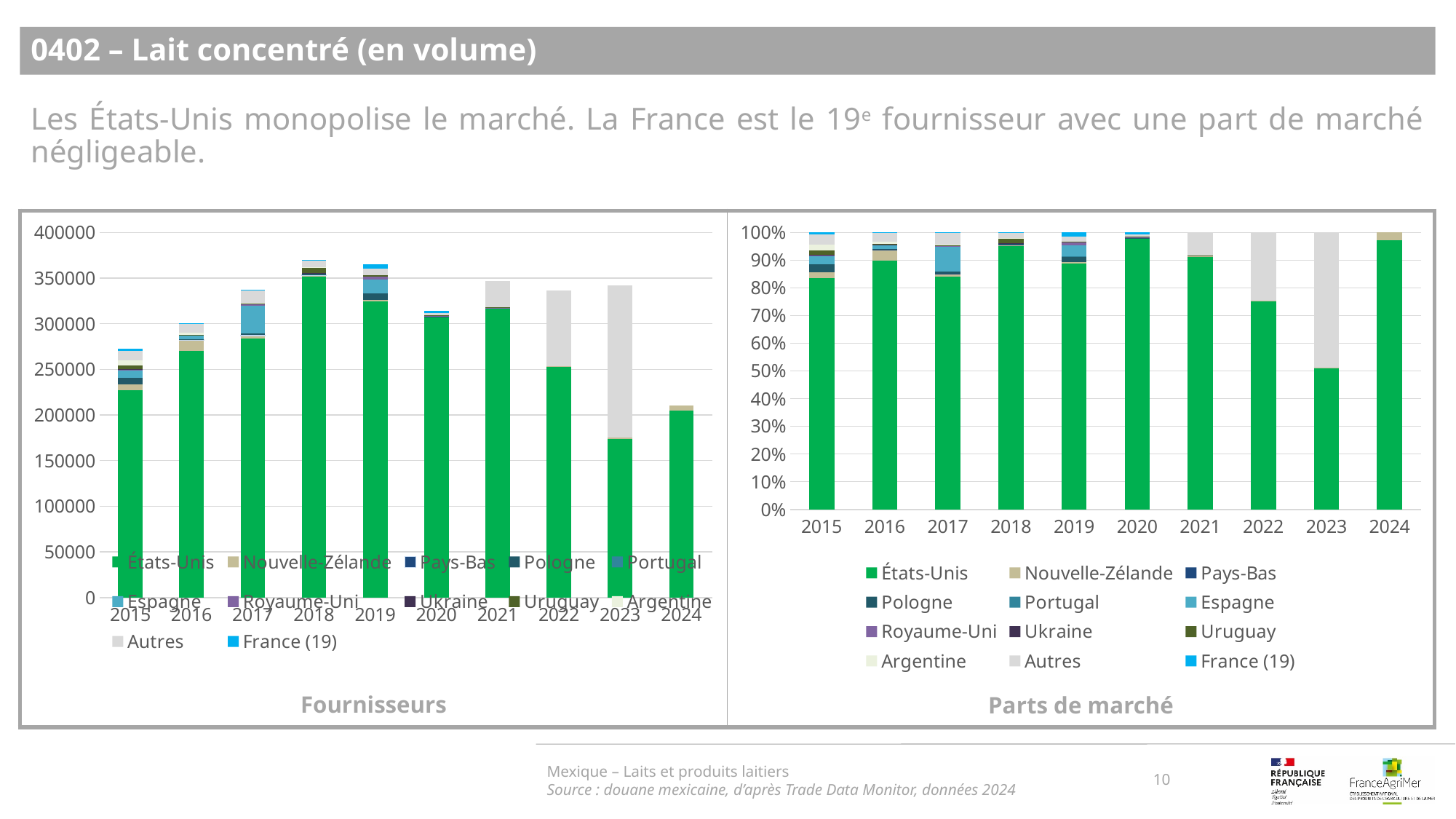
In the 'Fournisseurs' chart, is the value for États-Unis in 2018 greater or less than 300000? greater In the 'Parts de marché' chart, is the share of États-Unis in 2022 greater or less than 70%? greater In the 'Fournisseurs' chart, is the value for États-Unis in 2023 greater or less than 200000? less In the 'Parts de marché' chart, which is larger: the share of Autres in 2023 or in 2022? 2023 In the 'Parts de marché' chart, does the share of États-Unis rise or fall from 2020 to 2023? fall How many series does the legend of the 'Parts de marché' chart list? 12 How many years are shown on the x axis of the 'Parts de marché' chart? 10 In the 'Fournisseurs' chart, which year has the lowest value for États-Unis? 2023 What kind of chart is the 'Fournisseurs' chart on the left? stacked bar chart In the 'Fournisseurs' chart, which year has the lowest total bar? 2024